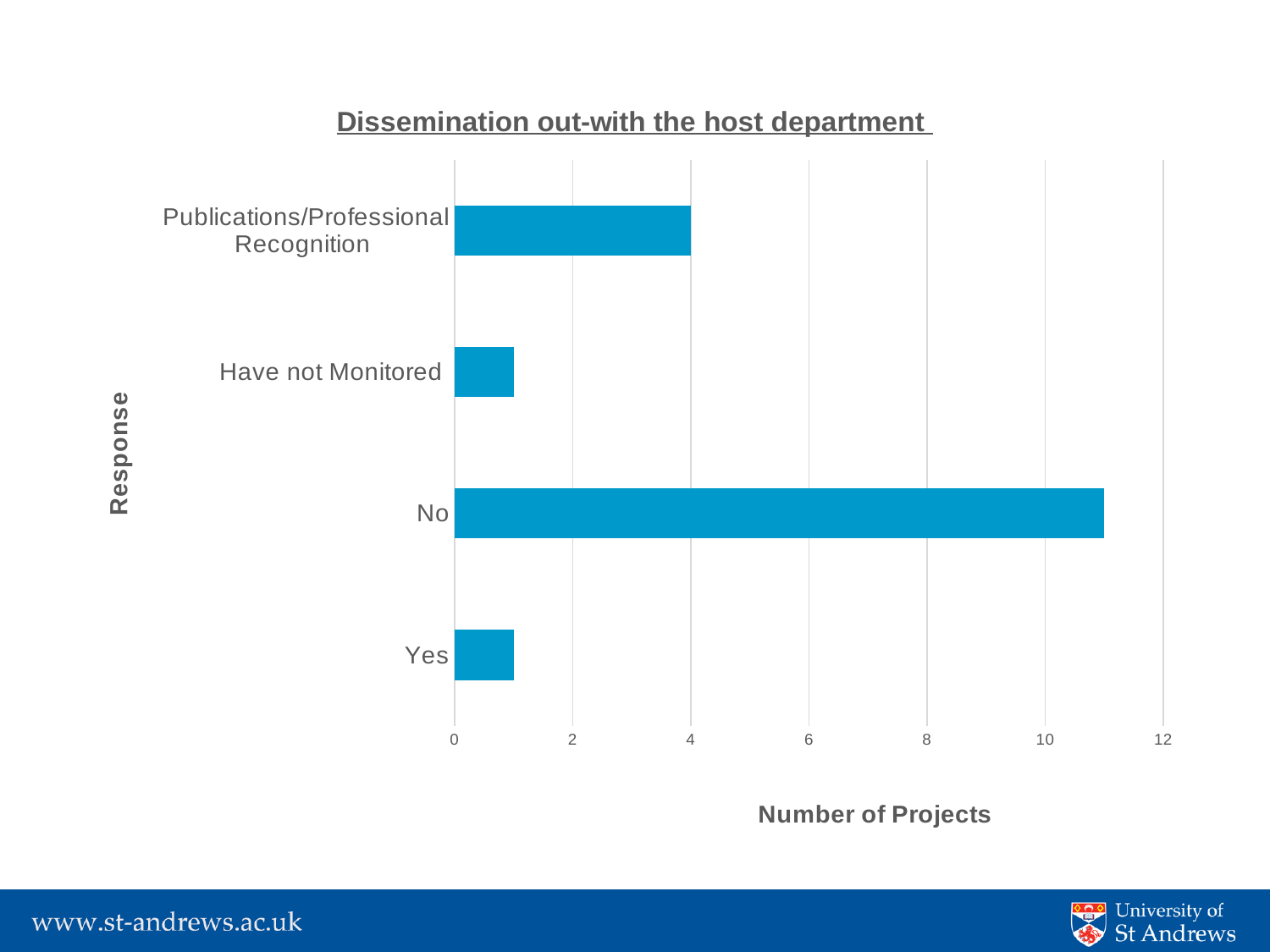
Is the number of projects for No greater or less than 12? less What type of chart is shown on the slide? Bar chart Which has more projects, No or Publications/Professional Recognition? No Which response has the highest number of projects? No What is the title of the chart? Dissemination out-with the host department Is the number of projects for No greater or less than 10? greater Is the number of projects for Yes greater or less than 2? less How many response categories are shown on the chart? 4 Which has more projects, Publications/Professional Recognition or Yes? Publications/Professional Recognition What is the number of projects for Publications/Professional Recognition? 4 What is the label of the horizontal axis? Number of Projects